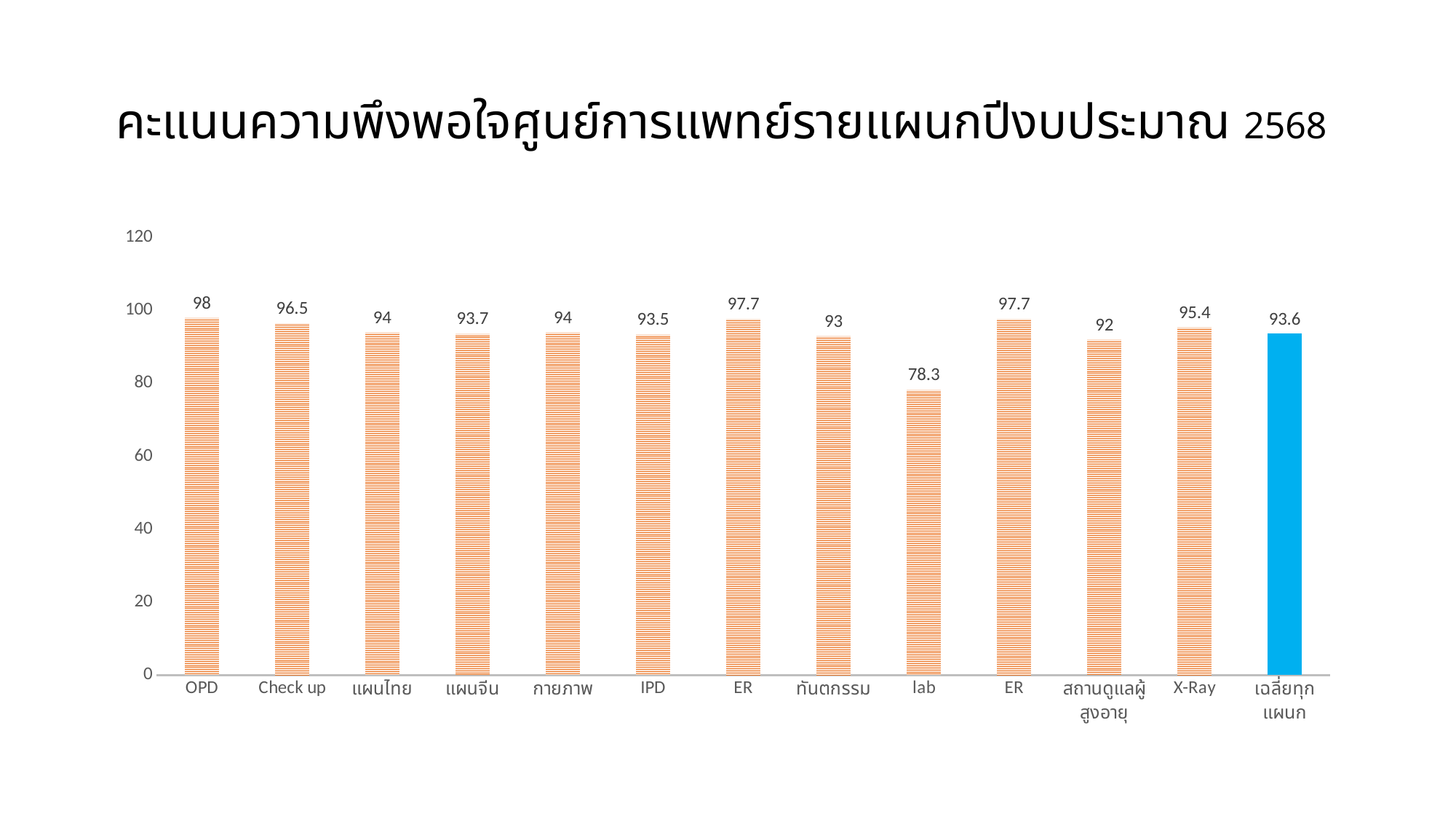
How many bars are shown in the chart? 13 Which category has the lowest value? lab Which is larger, the value for Check up or the value for IPD? Check up What is the value for lab? 78.3 What kind of chart is shown on the slide? bar chart What is the difference between the values for OPD and lab? 19.7 What is the value for เฉลี่ยทุกแผนก (the blue bar)? 93.6 Which bar is coloured blue instead of orange? เฉลี่ยทุกแผนก Is the value for lab greater or less than 80? less What is the value for OPD? 98 Which category has the highest value? OPD What is the value for X-Ray? 95.4